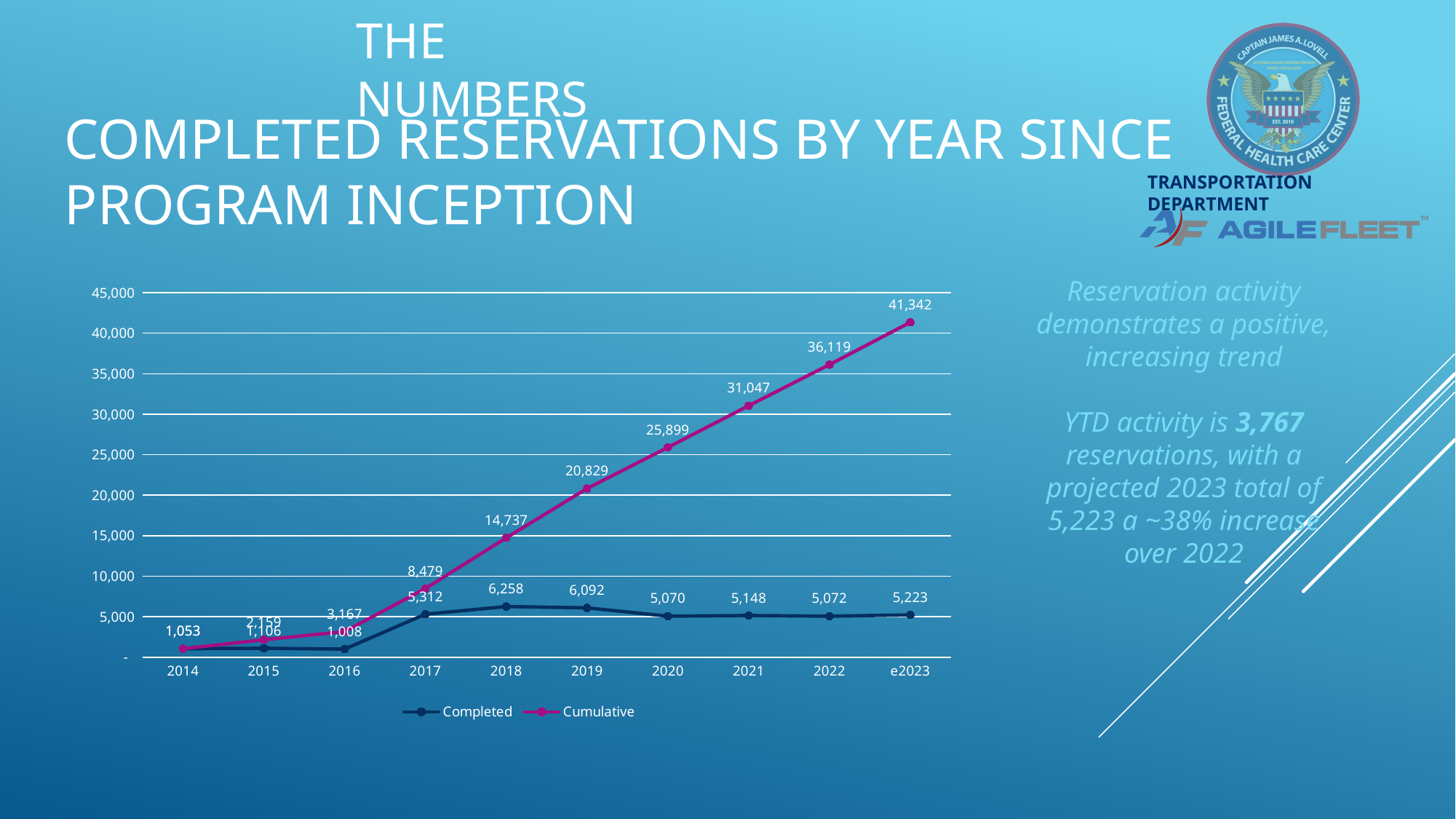
How many series does the legend list? 2 What is the Completed value for 2018? 6,258 What is the Completed value for e2023? 5,223 How many years are plotted on the x axis? 10 Which year has the lowest Completed value? 2016 Which year has the highest Completed value? 2018 What colour is the Cumulative line? Magenta What type of chart is shown on the slide? Line chart Which is larger, the Completed value for 2019 or for 2020? 2019 What is the difference between the Cumulative values for 2022 and 2021? 5,072 What is the Cumulative value for 2020? 25,899 Does the Cumulative series rise or fall from 2014 to e2023? Rise